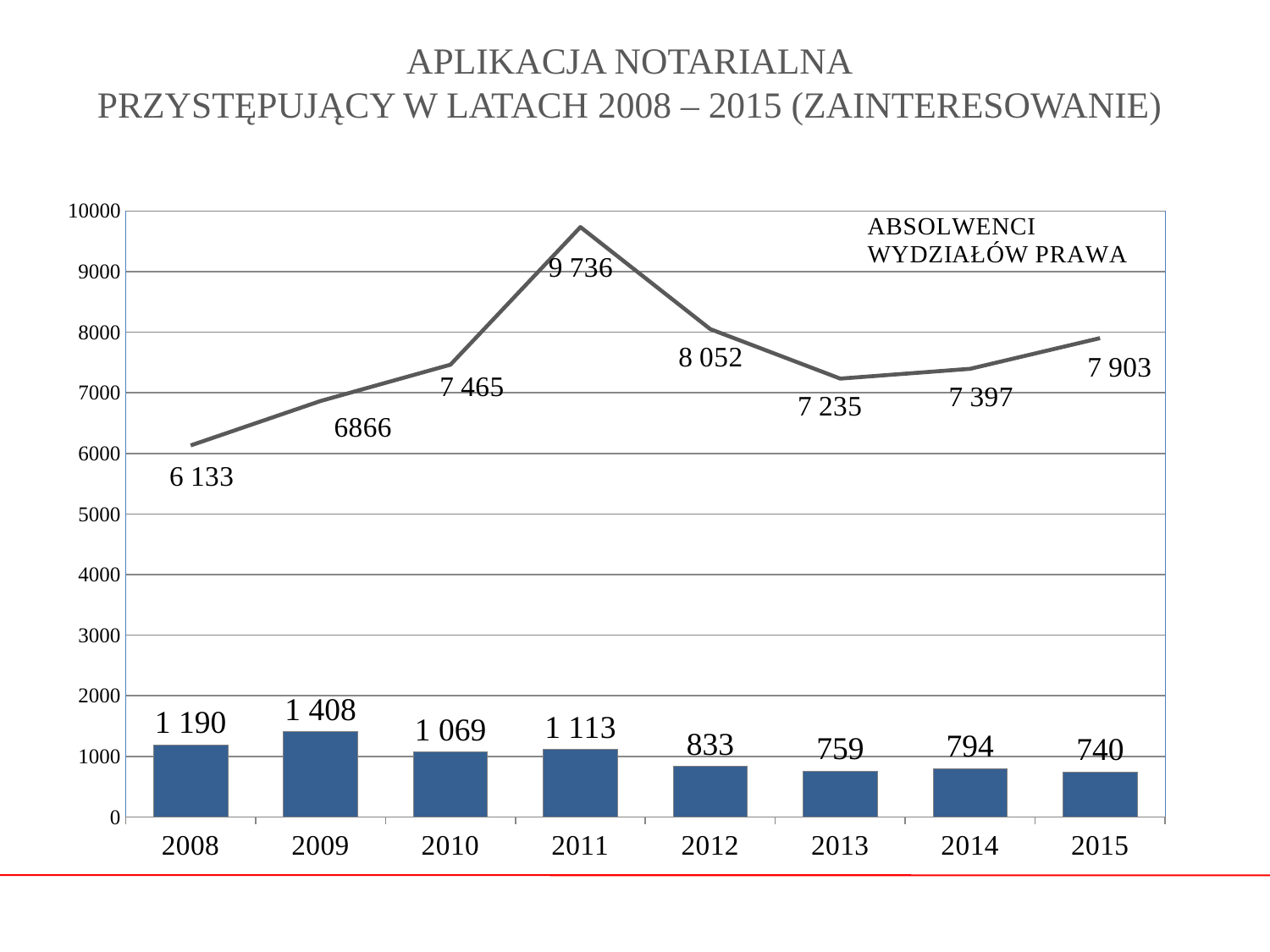
In which year is the bar value the highest? 2009 What label is shown next to the line series on the chart? ABSOLWENCI WYDZIAŁÓW PRAWA In which year does the ABSOLWENCI WYDZIAŁÓW PRAWA line reach its highest value? 2011 In which year is the bar value the lowest? 2015 What is the value of the bar for 2009? 1 408 How many years are shown on the x axis? 8 Do the bar values generally rise or fall from 2011 to 2015? fall What is the difference between the bar values for 2009 and 2015? 668 What is the value of the ABSOLWENCI WYDZIAŁÓW PRAWA line in 2011? 9 736 Which is larger, the bar value for 2013 or for 2014? 2014 What is the value of the bar for 2015? 740 What is the value of the ABSOLWENCI WYDZIAŁÓW PRAWA line in 2008? 6 133